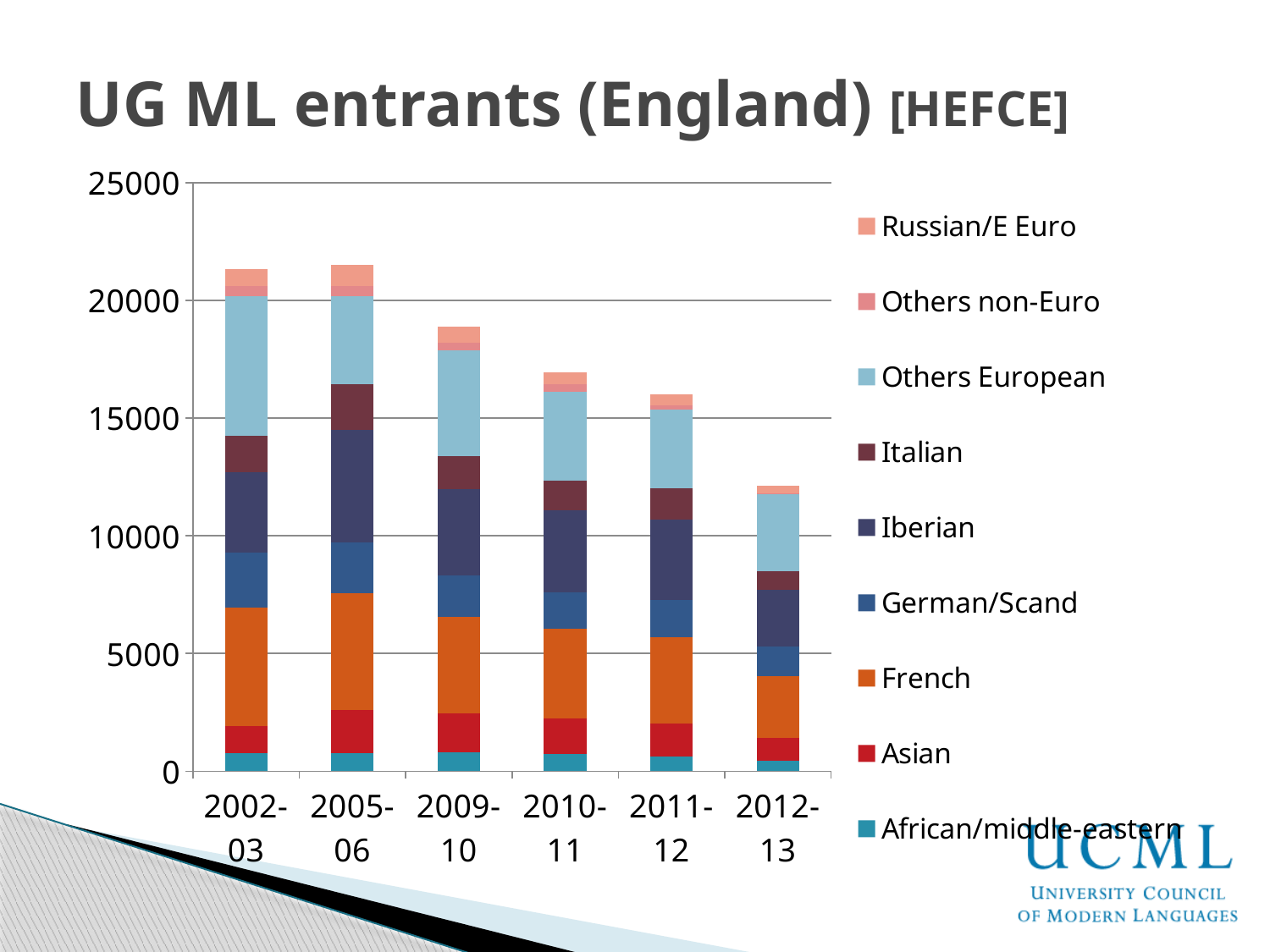
Is the total for 2010-11 greater or less than 20000? less How many academic-year categories are shown on the x axis? 6 What is the title of the chart on the slide? UG ML entrants (England) [HEFCE] Which series is listed at the bottom of the legend? African/middle-eastern Do the total bar heights generally rise or fall from 2002-03 to 2012-13? Fall Which year has the larger total of entrants, 2009-10 or 2012-13? 2009-10 Is the total for 2011-12 greater or less than 15000? greater How many series does the legend list? 9 Is the total for 2012-13 greater or less than 15000? less Which year has the lowest total number of UG ML entrants? 2012-13 What kind of chart is shown on the slide? Stacked bar chart